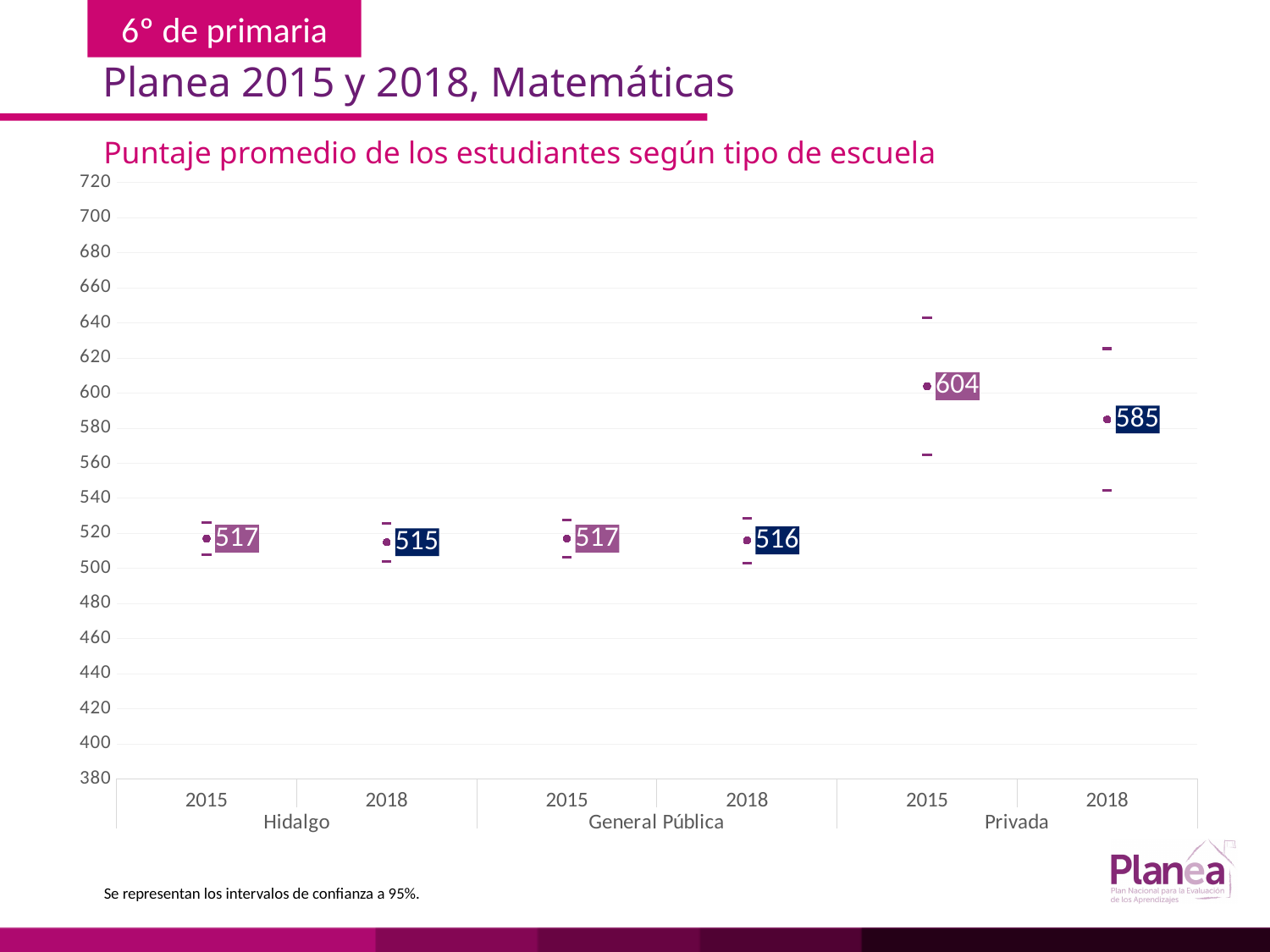
What is the average score for Privada in 2015? 604 Which is larger, the Privada 2018 score or the General Pública 2018 score? Privada 2018 What is the difference between the Privada scores in 2015 and 2018? 19 What is the average score for Hidalgo in 2015? 517 Which school type and year has the lowest average score? Hidalgo 2018 What is the average score for Hidalgo in 2018? 515 What is the average score for General Pública in 2018? 516 Did the Privada average score rise or fall from 2015 to 2018? fall What is the average score for Privada in 2018? 585 Which school type and year has the highest average score? Privada 2015 What is the title of the chart? Puntaje promedio de los estudiantes según tipo de escuela